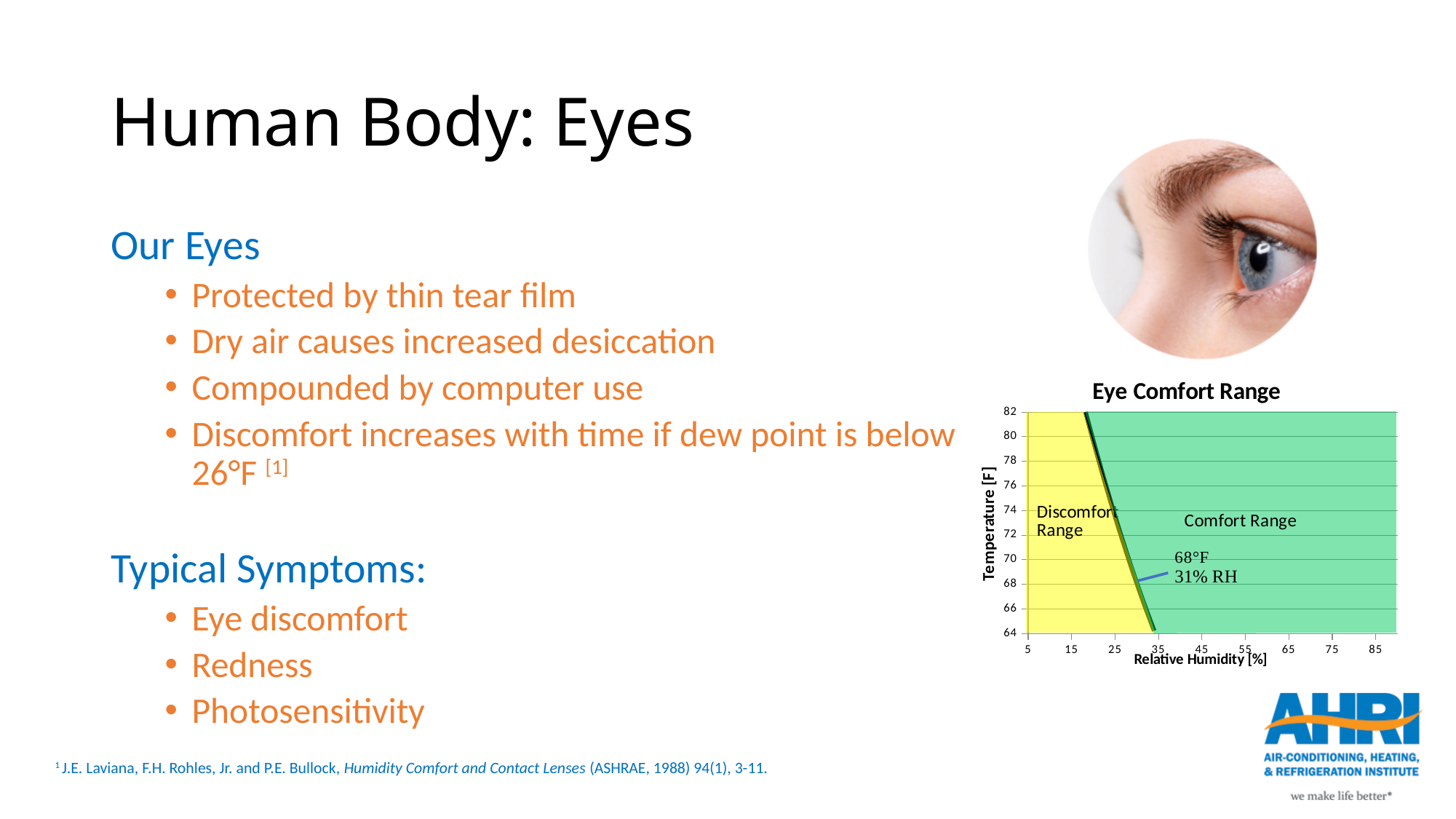
In the Eye Comfort Range chart, which region is shown in green? Comfort Range In the Eye Comfort Range chart, does the relative humidity at the boundary between the Discomfort Range and Comfort Range rise or fall as temperature increases? fall What is the label of the x axis of the Eye Comfort Range chart? Relative Humidity [%] What is the lowest temperature tick shown on the y axis of the Eye Comfort Range chart? 64 What is the highest temperature tick shown on the y axis of the Eye Comfort Range chart? 82 What is the label of the y axis of the Eye Comfort Range chart? Temperature [F] In the Eye Comfort Range chart, what temperature is given for the labeled point on the boundary line? 68°F What kind of chart is the Eye Comfort Range chart? area chart In the Eye Comfort Range chart, what relative humidity is given for the labeled point on the boundary line? 31% RH How many regions are labeled in the Eye Comfort Range chart? 2